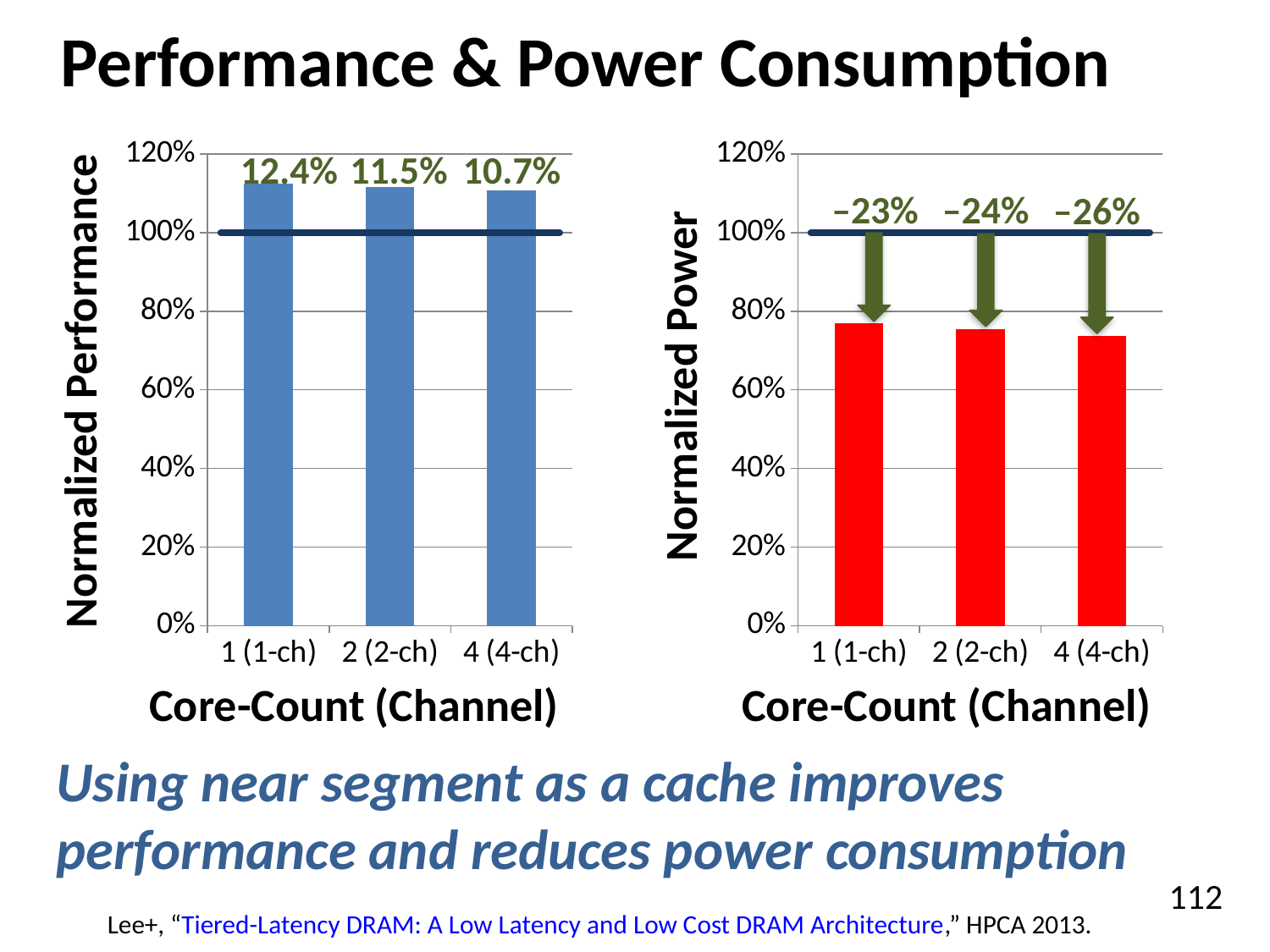
What is the x-axis title of the Normalized Performance chart (left)? Core-Count (Channel) In the Normalized Performance chart (left), what improvement is labeled above the bar for 4 (4-ch)? 10.7% In the Normalized Power chart (right), what power reduction is labeled for 2 (2-ch)? –24% In the Normalized Power chart (right), do the bar heights rise or fall as the core count increases from 1 to 4? fall How many core-count configurations are shown on the x axis of the Normalized Power chart (right)? 3 In the Normalized Power chart (right), what power reduction is labeled for 4 (4-ch)? –26% In the Normalized Performance chart (left), is the normalized performance for 2 (2-ch) greater or less than 100%? greater In the Normalized Performance chart (left), what is the difference between the labeled improvements for 1 (1-ch) and 4 (4-ch)? 1.7% In the Normalized Power chart (right), is the normalized power for 1 (1-ch) greater or less than 80%? less In the Normalized Performance chart (left), what performance improvement is labeled above the bar for 1 (1-ch)? 12.4% In the Normalized Performance chart (left), which core-count configuration has the largest labeled performance improvement? 1 (1-ch) In the Normalized Power chart (right), which core-count configuration has the lowest normalized power bar? 4 (4-ch)